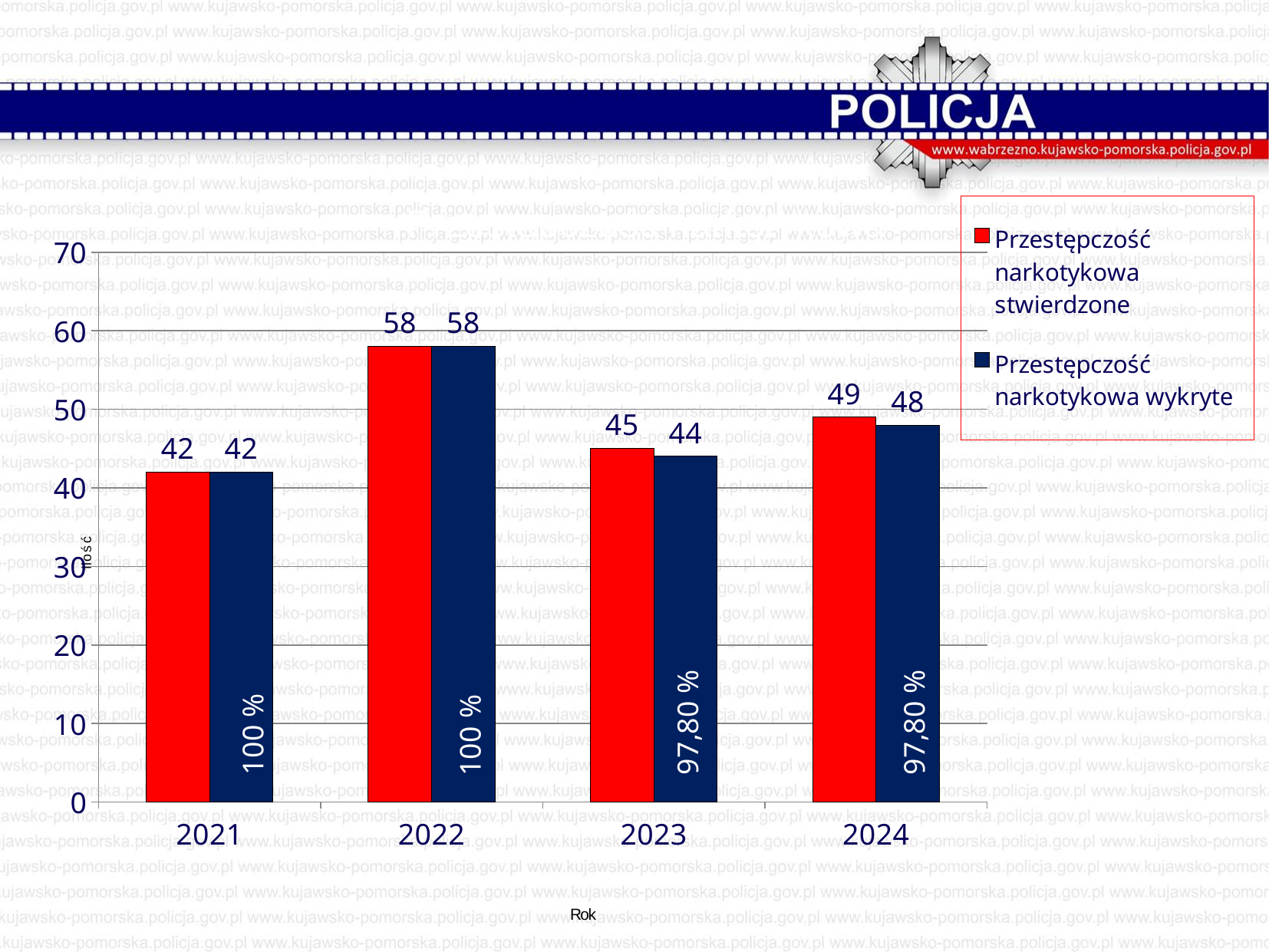
How many series does the legend list? 2 What is the value of Przestępczość narkotykowa stwierdzone in 2024? 49 In which year is Przestępczość narkotykowa wykryte lowest? 2021 In which year is Przestępczość narkotykowa stwierdzone highest? 2022 What is the value of Przestępczość narkotykowa stwierdzone in 2022? 58 What type of chart is shown on the slide? bar chart What colour are the bars for Przestępczość narkotykowa stwierdzone? red What is the difference between Przestępczość narkotykowa stwierdzone in 2022 and in 2021? 16 What is the value of Przestępczość narkotykowa wykryte in 2023? 44 What percentage label is printed on the Przestępczość narkotykowa wykryte bar for 2023? 97,80 % Which is larger in 2024: Przestępczość narkotykowa stwierdzone or Przestępczość narkotykowa wykryte? Przestępczość narkotykowa stwierdzone How many years are shown on the x axis? 4